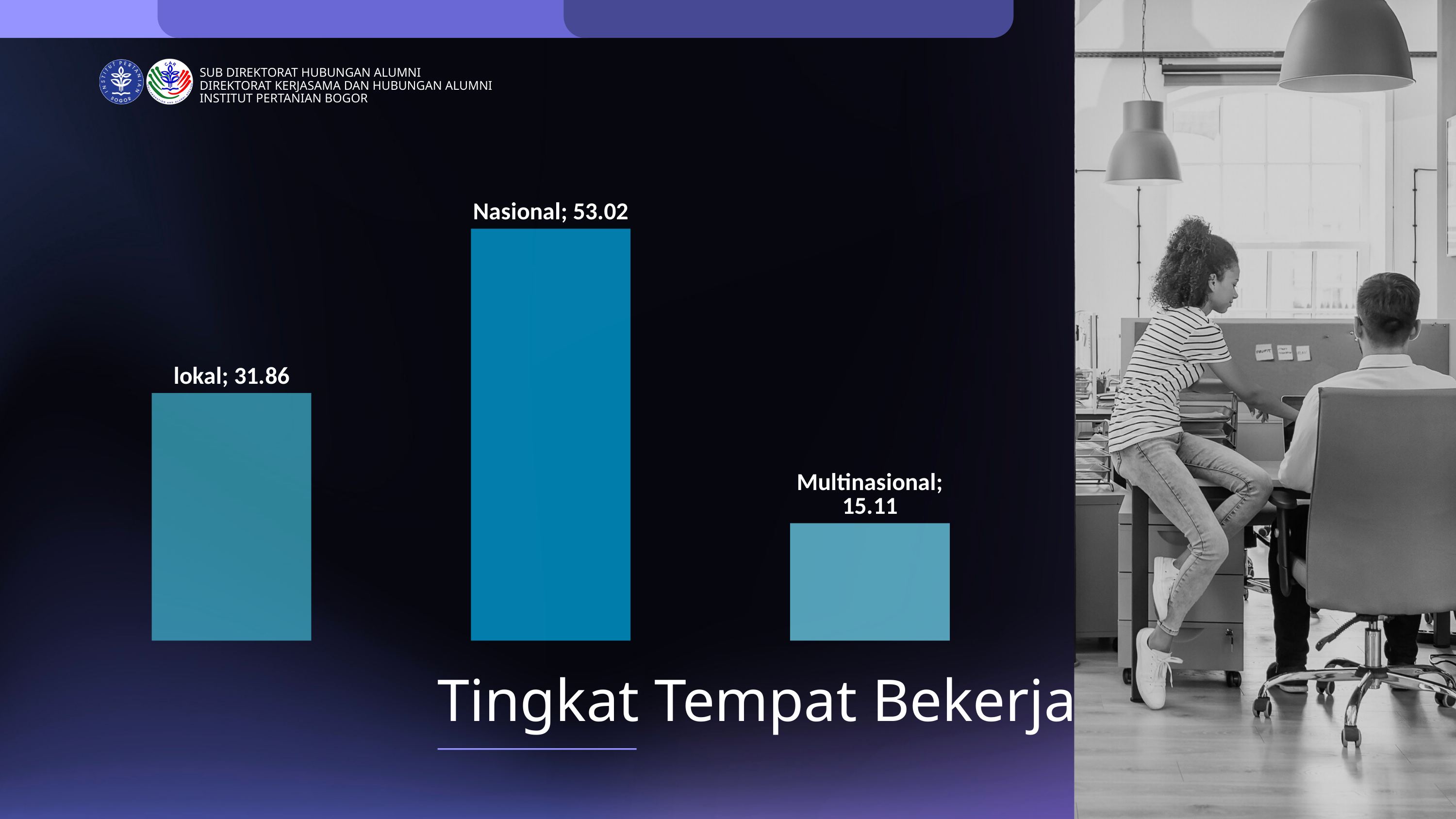
What is the title shown below the chart? Tingkat Tempat Bekerja What is the difference between the values for Nasional and lokal? 21.16 What is the total of the three values shown in the chart? 99.99 How many categories are shown in the chart? 3 What is the value for lokal? 31.86 Which category has the lowest value? Multinasional What kind of chart is shown on the slide? bar chart What is the value for Multinasional? 15.11 What is the value for Nasional? 53.02 Which category has the highest value? Nasional What is the difference between the values for lokal and Multinasional? 16.75 Which is larger, the value for lokal or the value for Multinasional? lokal